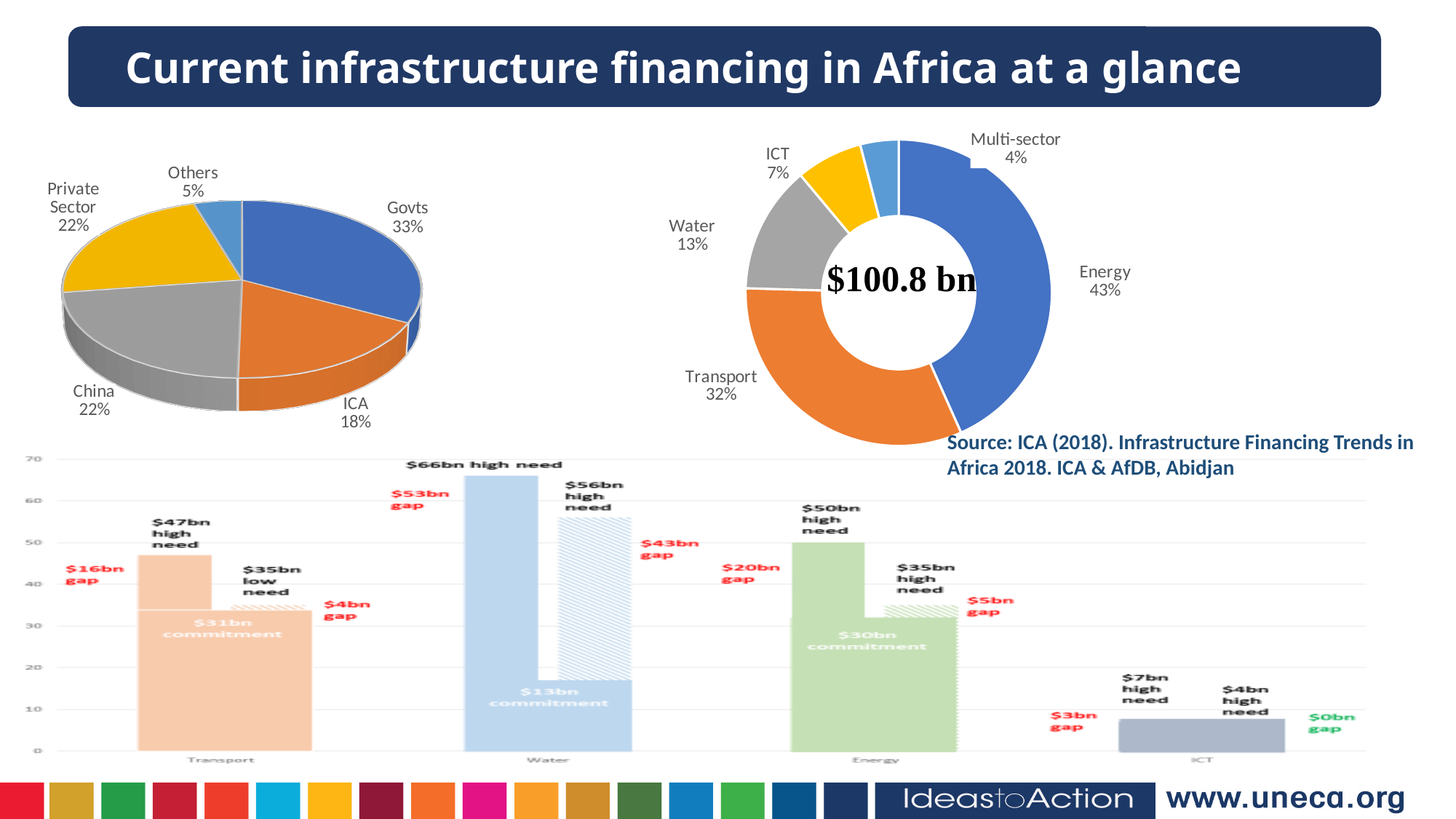
In the donut chart on the top right, what share is labelled for Energy? 43% In the bar chart at the bottom, how many sectors are shown on the x axis? 4 In the pie chart on the top left, how many categories are shown? 5 In the pie chart on the top left, which category has the smallest share? Others In the pie chart on the top left, what share is labelled for Govts? 33% In the pie chart on the top left, what is the difference between the Govts share and the ICA share? 15% In the donut chart on the top right, which sector has the smallest share? Multi-sector In the donut chart on the top right, which sector has the largest share? Energy In the bar chart at the bottom, what is the high need value labelled for Water? $66bn high need In the donut chart on the top right, which is larger: the share for Water or the share for ICT? Water In the donut chart on the top right, what total amount is printed in the centre? $100.8 bn In the bar chart at the bottom, what is the commitment value labelled for Energy? $30bn commitment